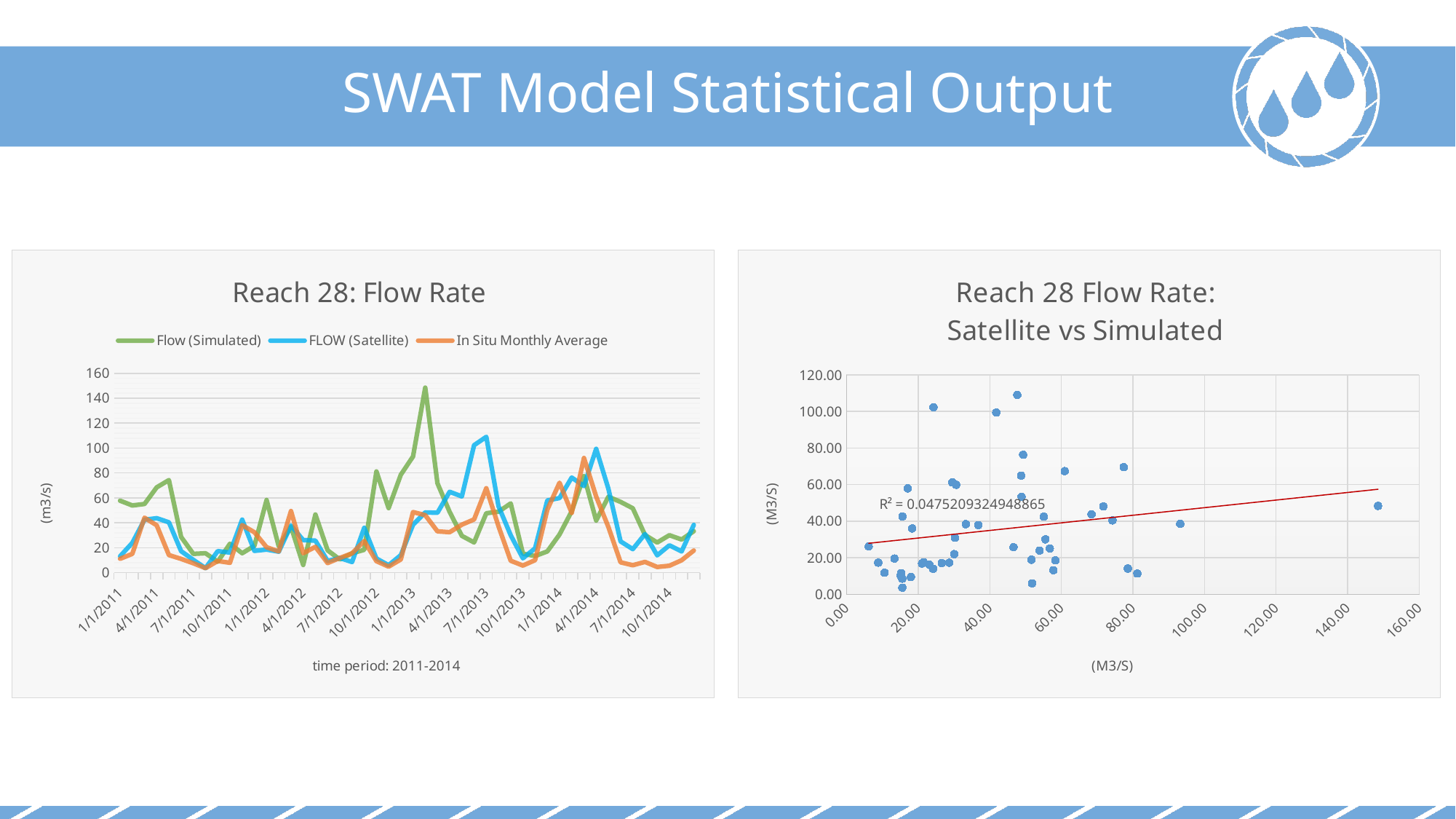
In the 'Reach 28 Flow Rate: Satellite vs Simulated' chart, is the y value of the rightmost point (near x = 150) greater or less than 60.00? less How many series does the legend of the 'Reach 28: Flow Rate' chart list? 3 In the 'Reach 28: Flow Rate' chart, which series reaches the highest value over the whole period? Flow (Simulated) In the 'Reach 28: Flow Rate' chart, is the peak value of FLOW (Satellite) around 7/1/2013 greater or less than 100? greater What kind of chart is the right chart, 'Reach 28 Flow Rate: Satellite vs Simulated'? scatter chart What is the y-axis label of the 'Reach 28: Flow Rate' chart? (m3/s) What is the x-axis label of the 'Reach 28: Flow Rate' chart? time period: 2011-2014 What kind of chart is the left chart, 'Reach 28: Flow Rate'? line chart In the 'Reach 28: Flow Rate' chart, is the peak value of In Situ Monthly Average around 4/1/2014 greater or less than 80? greater In the 'Reach 28 Flow Rate: Satellite vs Simulated' chart, does the trendline rise or fall as the x value increases? rise What R² value is printed on the 'Reach 28 Flow Rate: Satellite vs Simulated' chart? R² = 0.0475209324948865